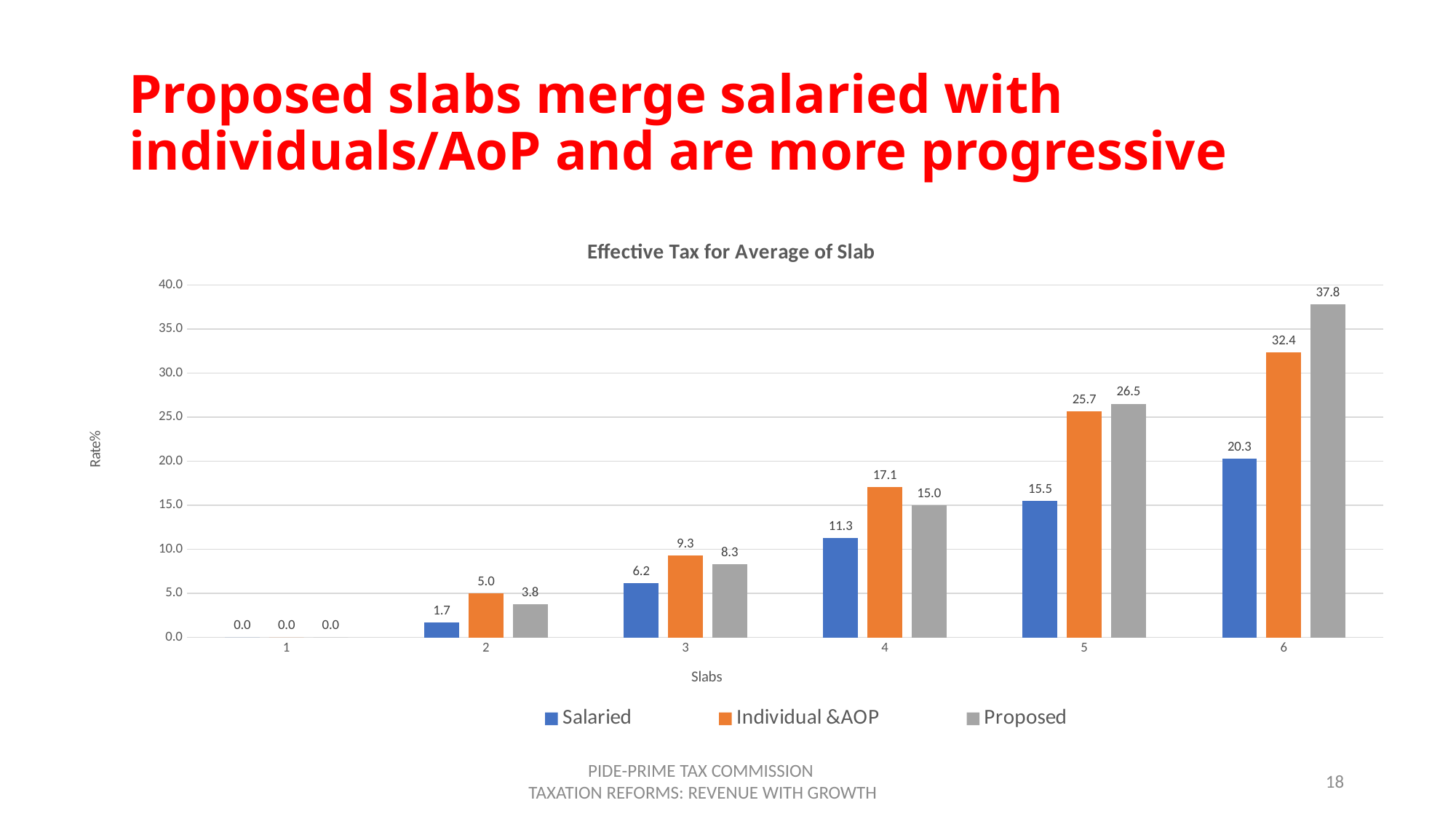
How many series does the legend list? 3 What is the Salaried value for slab 4? 11.3 Do the Proposed values rise or fall from slab 1 to slab 6? rise Is the Proposed value for slab 5 greater or less than 25.0? greater For slab 4, which is larger: the Individual &AOP value or the Proposed value? Individual &AOP What is the Individual &AOP value for slab 3? 9.3 What is the Proposed value for slab 6? 37.8 What is the difference between the Individual &AOP and Salaried values for slab 6? 12.1 Which slab has the highest Salaried value? 6 What kind of chart is shown? bar chart Which slab has the lowest Proposed value? 1 How many slabs are shown on the x axis? 6